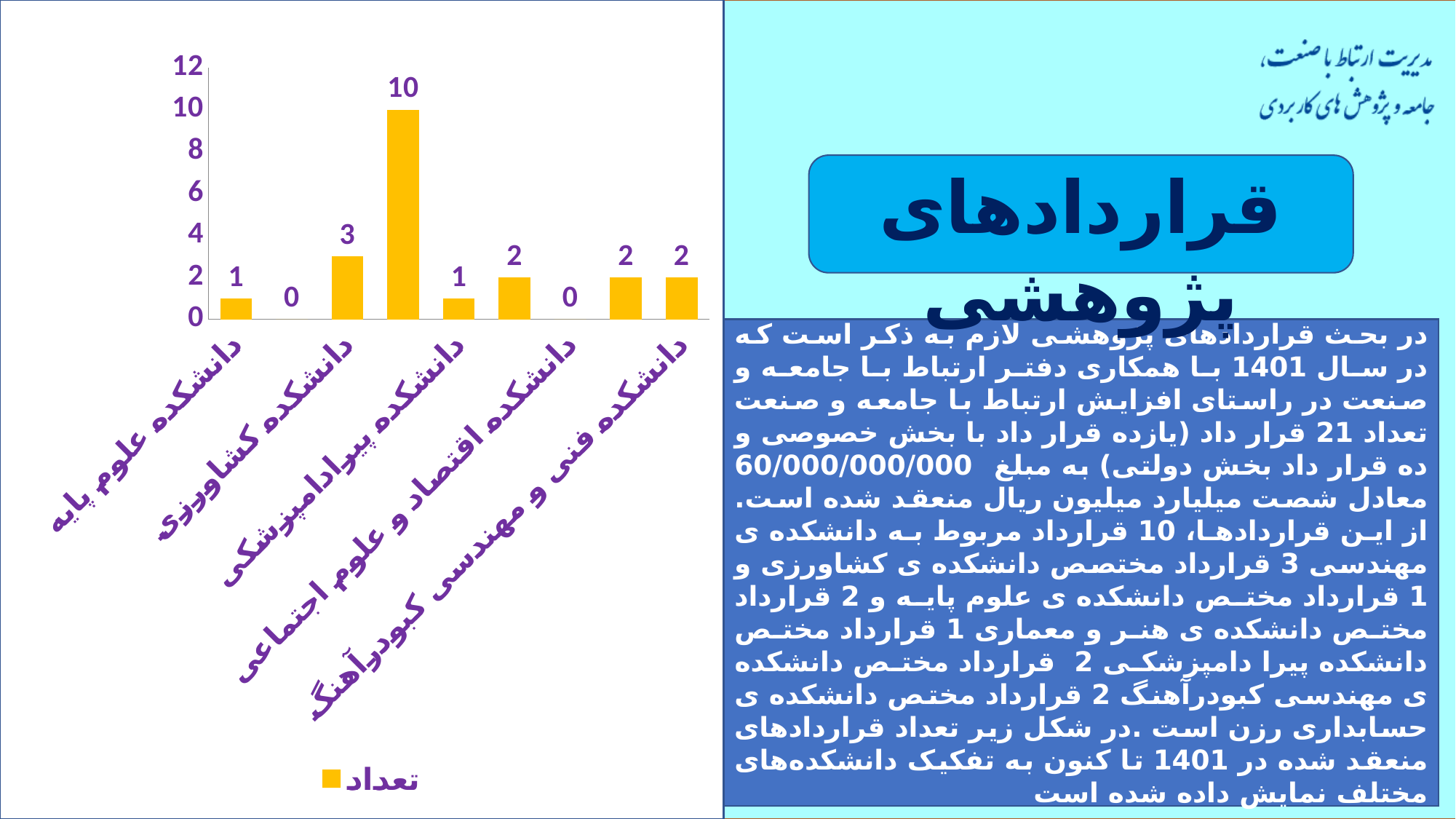
What is the value for دانشکده فنی و مهندسی کبودرآهنگ? 2 What type of chart is shown on the slide? bar chart What is the highest value shown by any bar in the chart? 10 How many bars (categories) are plotted in the chart? 9 What is the value for دانشکده کشاورزی? 3 How many series does the chart legend list? 1 What is the difference between the values for دانشکده کشاورزی and دانشکده علوم پایه? 2 Which has a larger value, دانشکده کشاورزی or دانشکده فنی و مهندسی کبودرآهنگ? دانشکده کشاورزی What is the value for دانشکده پیرادامپزشکی? 1 What is the name of the series shown in the chart legend? تعداد What is the value for دانشکده علوم پایه? 1 What is the value for دانشکده اقتصاد و علوم اجتماعی? 0